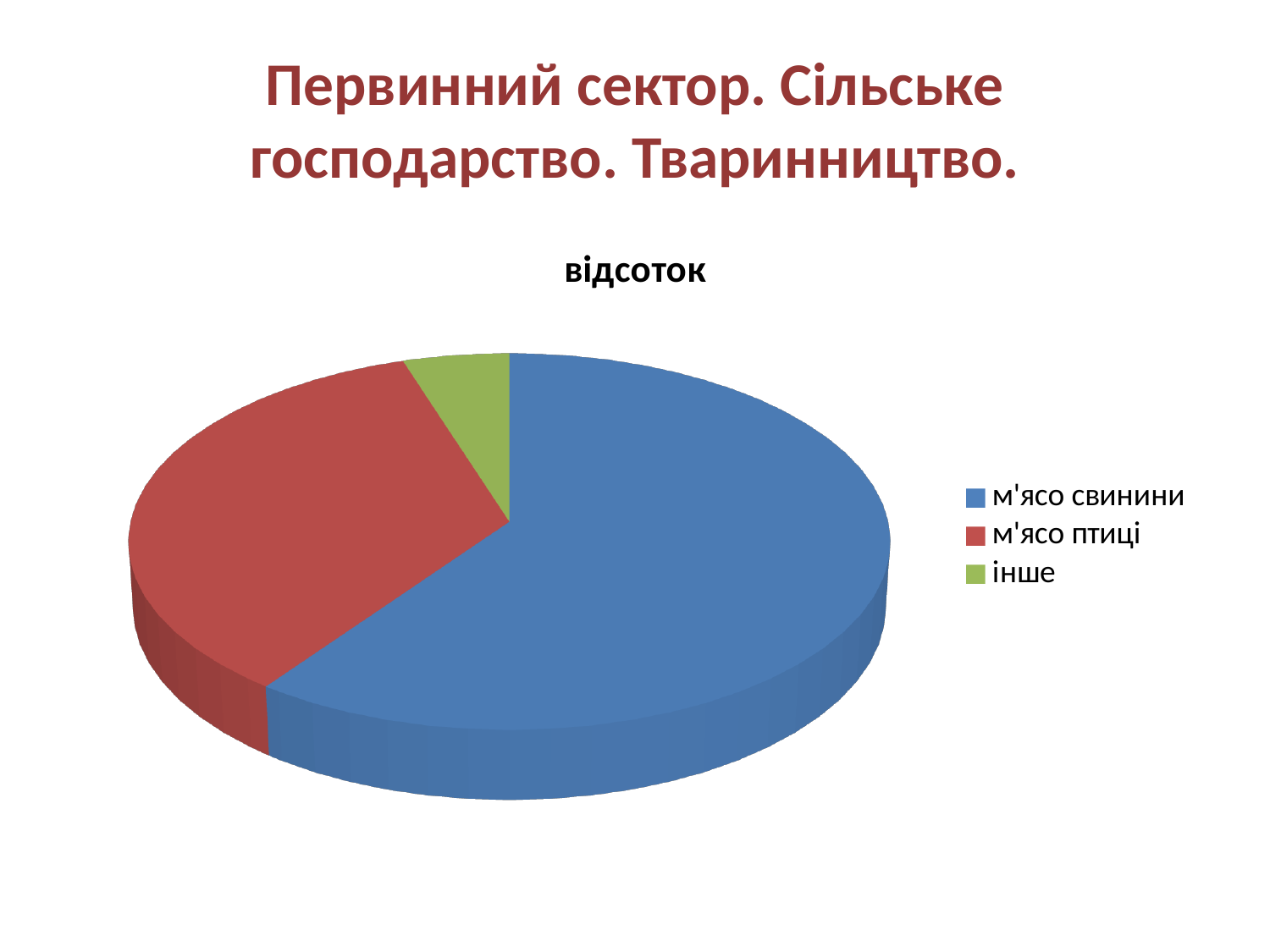
How many slices does the pie chart have? 3 What kind of chart is shown on the slide? pie chart What is the title of the chart? відсоток Which category has the largest slice of the pie? м'ясо свинини How many entries does the legend list? 3 Which category has the smallest slice of the pie? інше Which slice is larger, м'ясо птиці or інше? м'ясо птиці Which slice is larger, м'ясо свинини or м'ясо птиці? м'ясо свинини Which colour represents м'ясо птиці in the pie chart? red